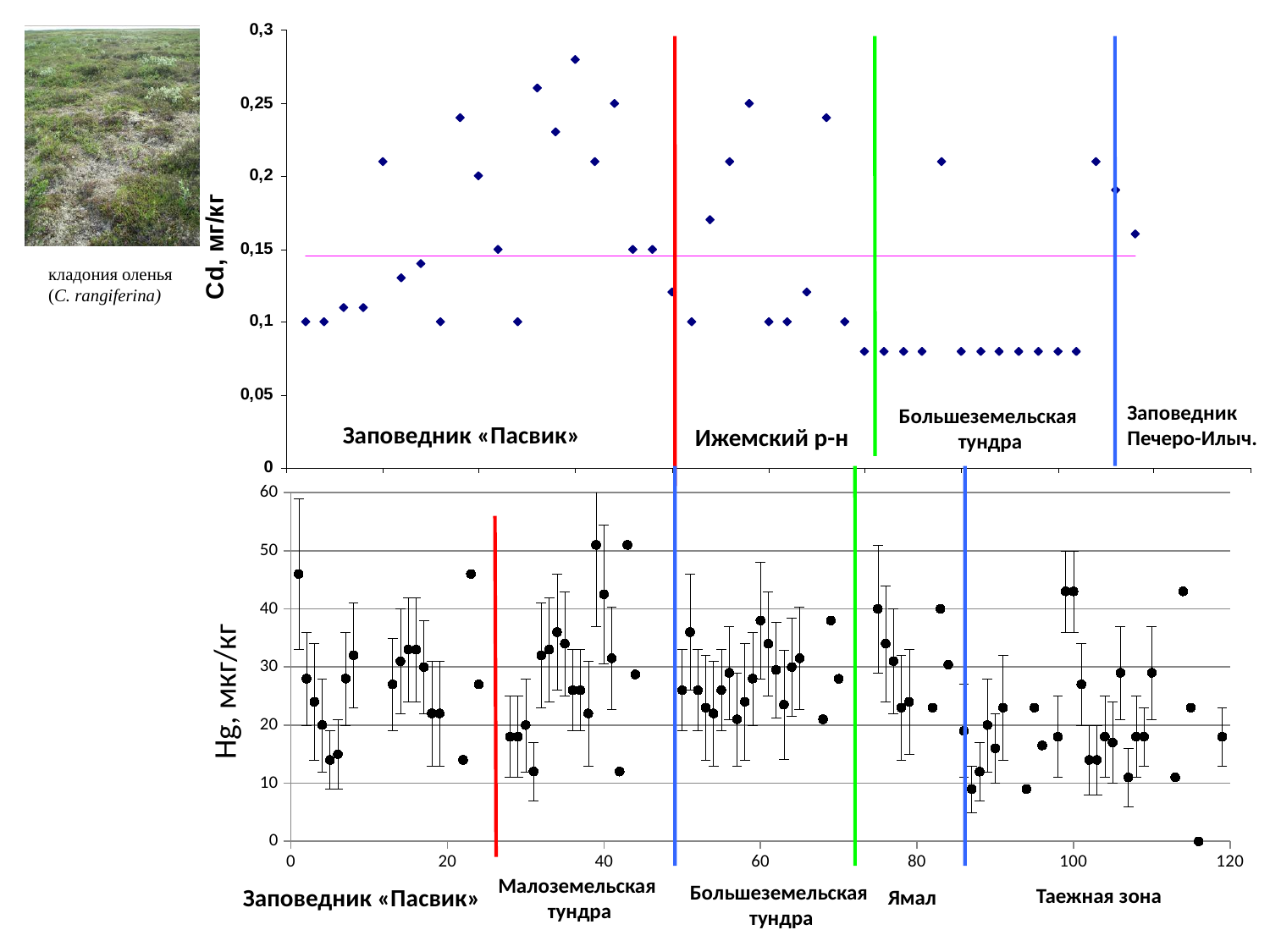
In the bottom chart (Hg), is the first point (at x = 1) greater or less than 40? greater How many regions are labelled along the bottom of the top chart (Cd)? 4 In the top chart (Cd), which region section contains the highest plotted point? Заповедник «Пасвик» How many regions are labelled along the bottom of the bottom chart (Hg)? 5 What kind of chart is the bottom chart (Hg, мкг/кг)? scatter chart What is the y-axis label of the bottom chart? Hg, мкг/кг In the top chart (Cd), are the values in the Большеземельская тундра section that lie on a flat line greater or less than 0,1? less What kind of chart is the top chart (Cd, мг/кг)? scatter chart In the top chart (Cd), is the highest point in the Заповедник «Пасвик» section greater or less than 0,25? greater In the bottom chart (Hg), what is the maximum value shown on the y-axis? 60 What is the y-axis label of the top chart? Cd, мг/кг